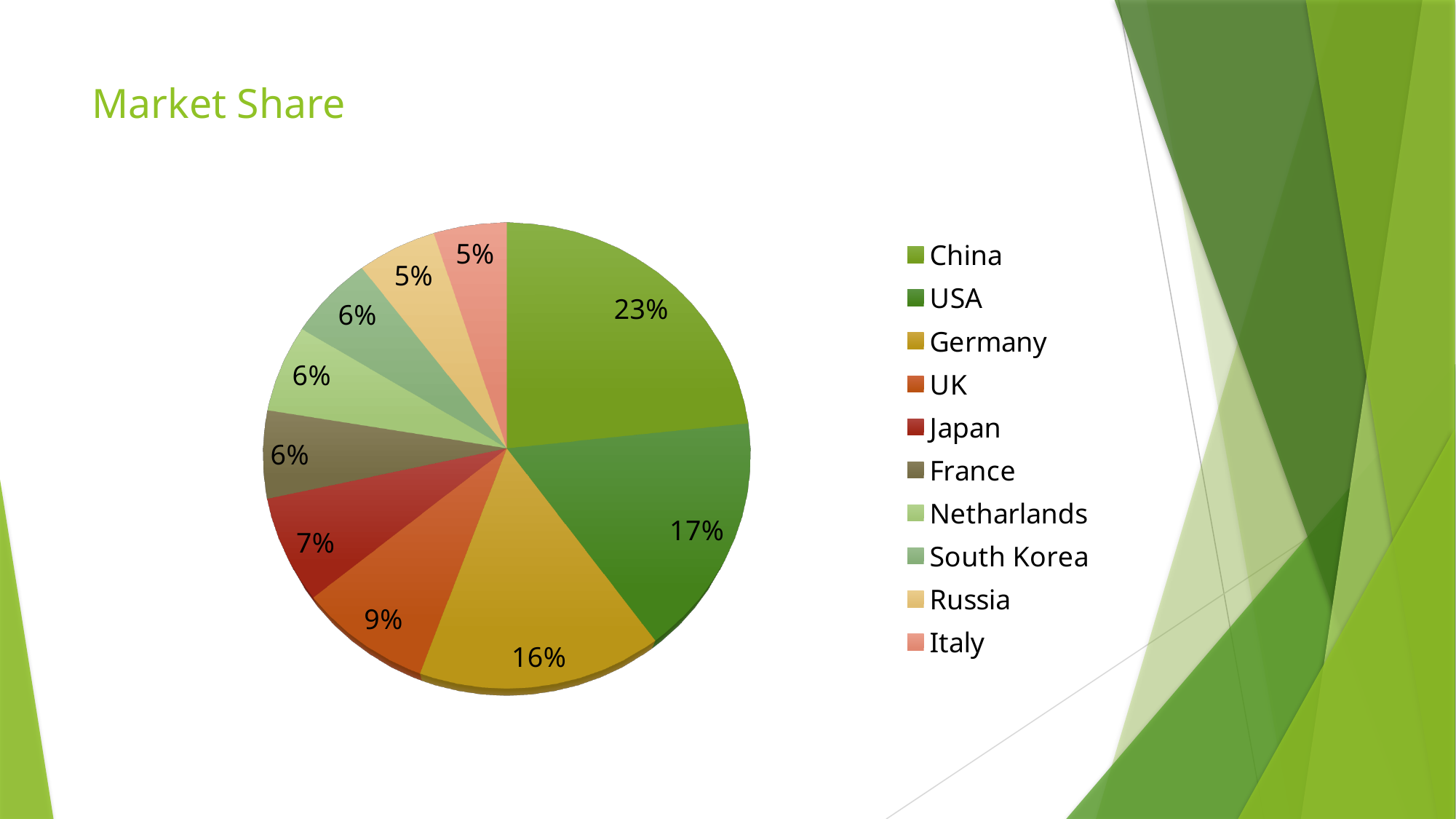
What is the value for Japan? 7% What is the difference between the shares of the UK and Japan? 2% What is the difference between the shares of China and USA? 6% What share of the pie does China hold? 23% What share of the pie does Germany hold? 16% Which is larger, the share for USA or the share for Germany? USA What is the title of the chart? Market Share Which country has the largest slice of the pie? China What is the value for the UK? 9% What type of chart is shown on the slide? Pie chart How many categories does the legend list? 10 What is the value for Russia? 5%